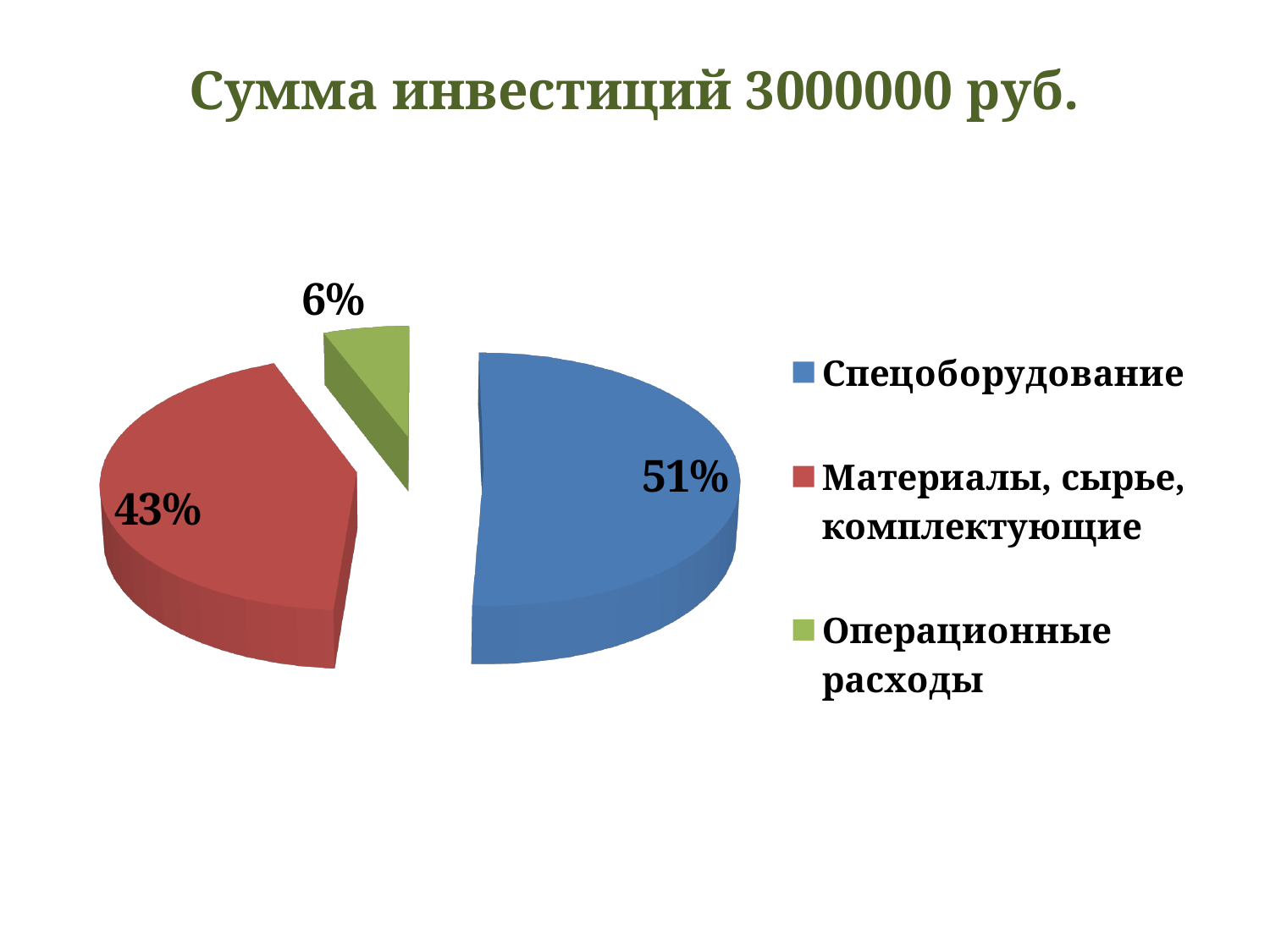
Which is larger: the share for Спецоборудование or the share for Операционные расходы? Спецоборудование What is the difference in percentage points between Материалы, сырье, комплектующие and Операционные расходы? 37% What share of the pie does Операционные расходы take? 6% What colour is the slice for Операционные расходы? green What is the title of the slide above the chart? Сумма инвестиций 3000000 руб. What share of the pie does Материалы, сырье, комплектующие take? 43% What kind of chart is shown on the slide? pie chart How many slices does the pie chart have? 3 What share of the pie does Спецоборудование take? 51% Which category has the smallest slice of the pie? Операционные расходы Which category has the largest slice of the pie? Спецоборудование What is the difference in percentage points between Спецоборудование and Материалы, сырье, комплектующие? 8%